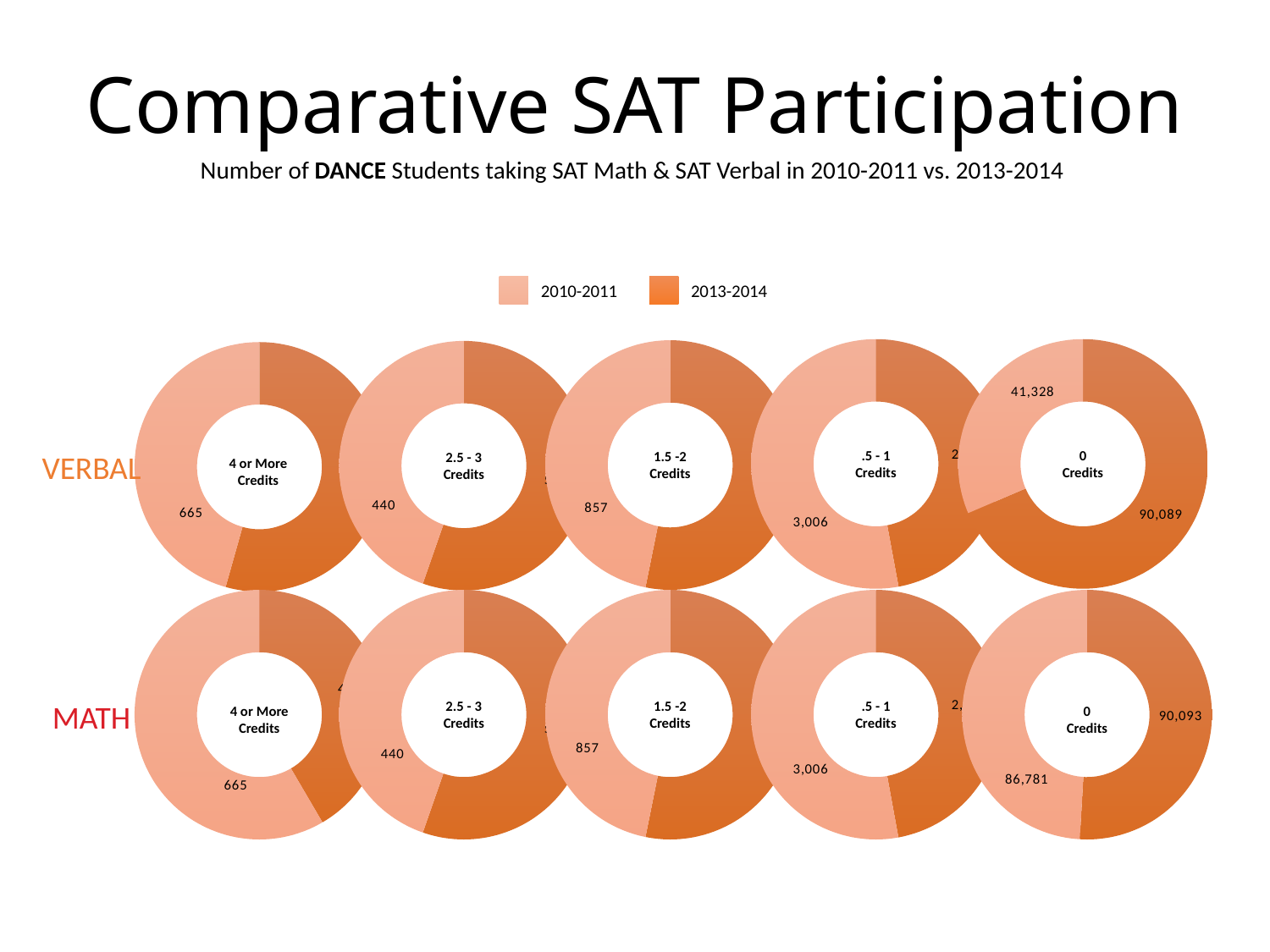
How many series does the legend list? 2 In the MATH row, 0 Credits chart, what is the value for 2013-2014? 90,093 What kind of chart is used on this slide to show SAT participation? Donut (pie) chart In the VERBAL row, 0 Credits chart, which year has the larger value, 2010-2011 or 2013-2014? 2013-2014 In the VERBAL row, 0 Credits chart, what is the value for 2010-2011? 41,328 How many donut charts are shown in the VERBAL row? 5 In the MATH row, 0 Credits chart, what is the value for 2010-2011? 86,781 Which legend entry is shown in the lighter orange colour? 2010-2011 In the VERBAL row, 4 or More Credits chart, what is the value for 2010-2011? 665 In the VERBAL row, 0 Credits chart, what is the value for 2013-2014? 90,089 In the MATH row, .5 - 1 Credits chart, what is the value for 2010-2011? 3,006 In the VERBAL row, 0 Credits chart, what is the difference between the 2013-2014 and 2010-2011 values? 48,761